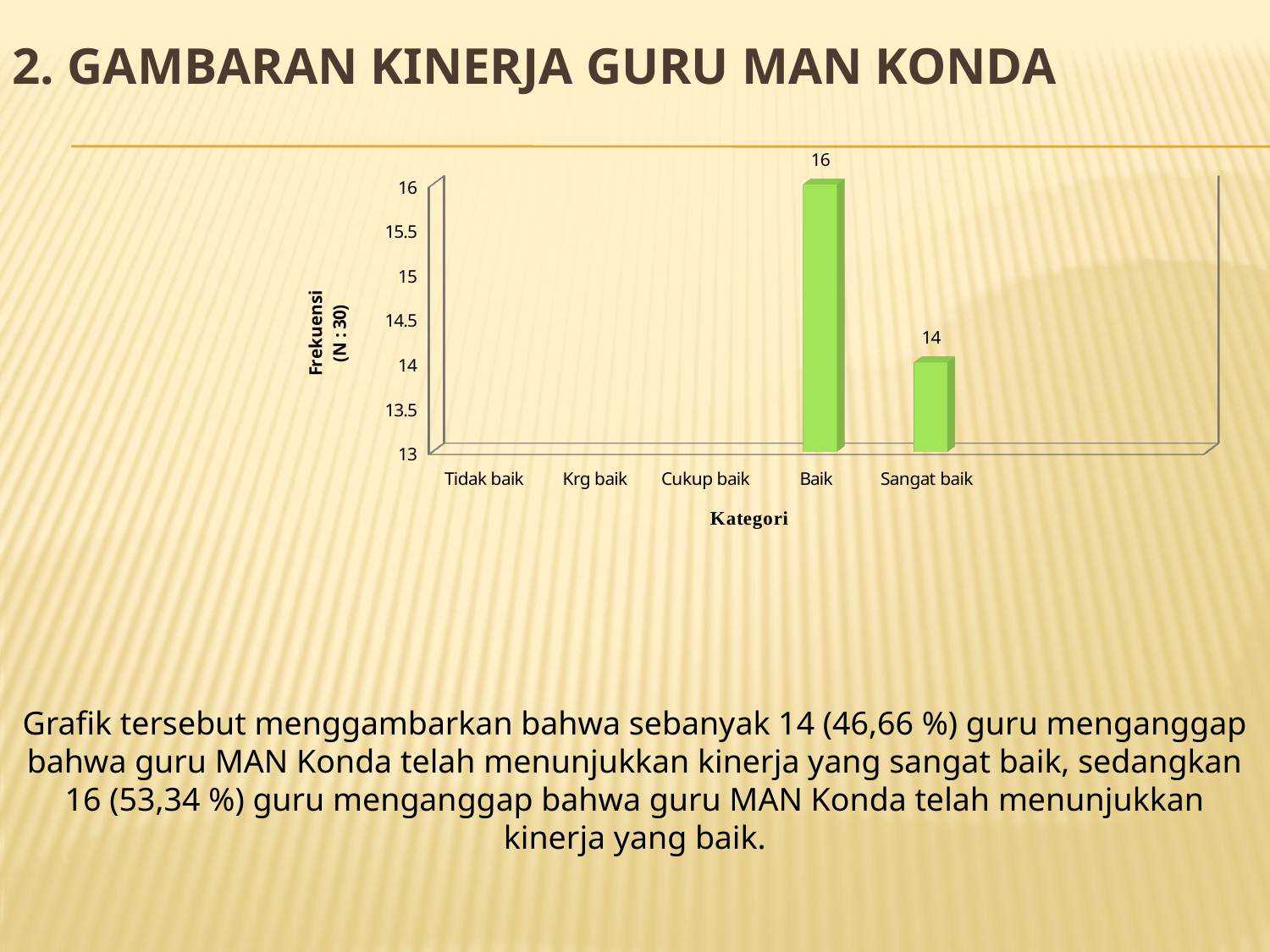
What is the difference between the values for Baik and Sangat baik? 2 What kind of chart is shown on the slide? bar chart Is the value for Baik greater or less than 15? greater What is the label of the x axis? Kategori What is the value for Baik? 16 What is the label of the y axis? Frekuensi (N : 30) How many categories are shown on the x axis? 5 Is the value for Sangat baik greater or less than 15? less What is the value for Sangat baik? 14 Which is larger, the value for Baik or the value for Sangat baik? Baik Which category has the highest value? Baik What is the lowest value shown on the y axis? 13